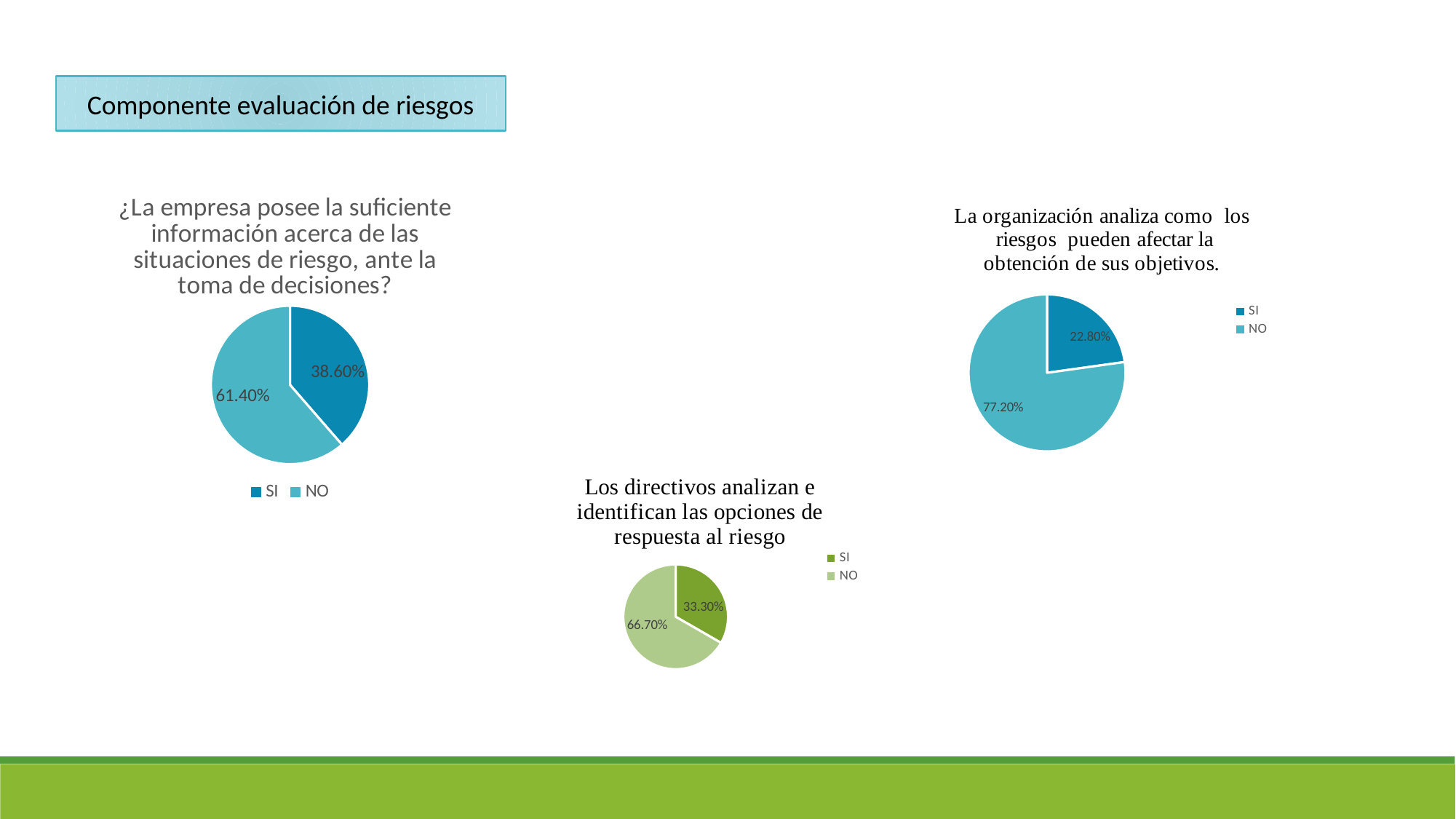
What type of chart is used for 'La organización analiza como los riesgos pueden afectar la obtención de sus objetivos.'? Pie chart In the left pie chart titled '¿La empresa posee la suficiente información acerca de las situaciones de riesgo, ante la toma de decisiones?', which category has the smallest slice? SI In the left pie chart titled '¿La empresa posee la suficiente información acerca de las situaciones de riesgo, ante la toma de decisiones?', what is the difference between the NO and SI values? 22.80% In the bottom-centre pie chart titled 'Los directivos analizan e identifican las opciones de respuesta al riesgo', what is the value for NO? 66.70% In the left pie chart titled '¿La empresa posee la suficiente información acerca de las situaciones de riesgo, ante la toma de decisiones?', what is the value for SI? 38.60% In the right pie chart titled 'La organización analiza como los riesgos pueden afectar la obtención de sus objetivos.', what is the value for NO? 77.20% In the left pie chart titled '¿La empresa posee la suficiente información acerca de las situaciones de riesgo, ante la toma de decisiones?', what is the value for NO? 61.40% In the bottom-centre pie chart titled 'Los directivos analizan e identifican las opciones de respuesta al riesgo', which is larger, SI or NO? NO In the bottom-centre pie chart titled 'Los directivos analizan e identifican las opciones de respuesta al riesgo', what is the value for SI? 33.30% In the right pie chart titled 'La organización analiza como los riesgos pueden afectar la obtención de sus objetivos.', which category has the largest slice? NO In the right pie chart titled 'La organización analiza como los riesgos pueden afectar la obtención de sus objetivos.', what is the value for SI? 22.80% How many categories does the legend of the bottom-centre pie chart titled 'Los directivos analizan e identifican las opciones de respuesta al riesgo' list? 2